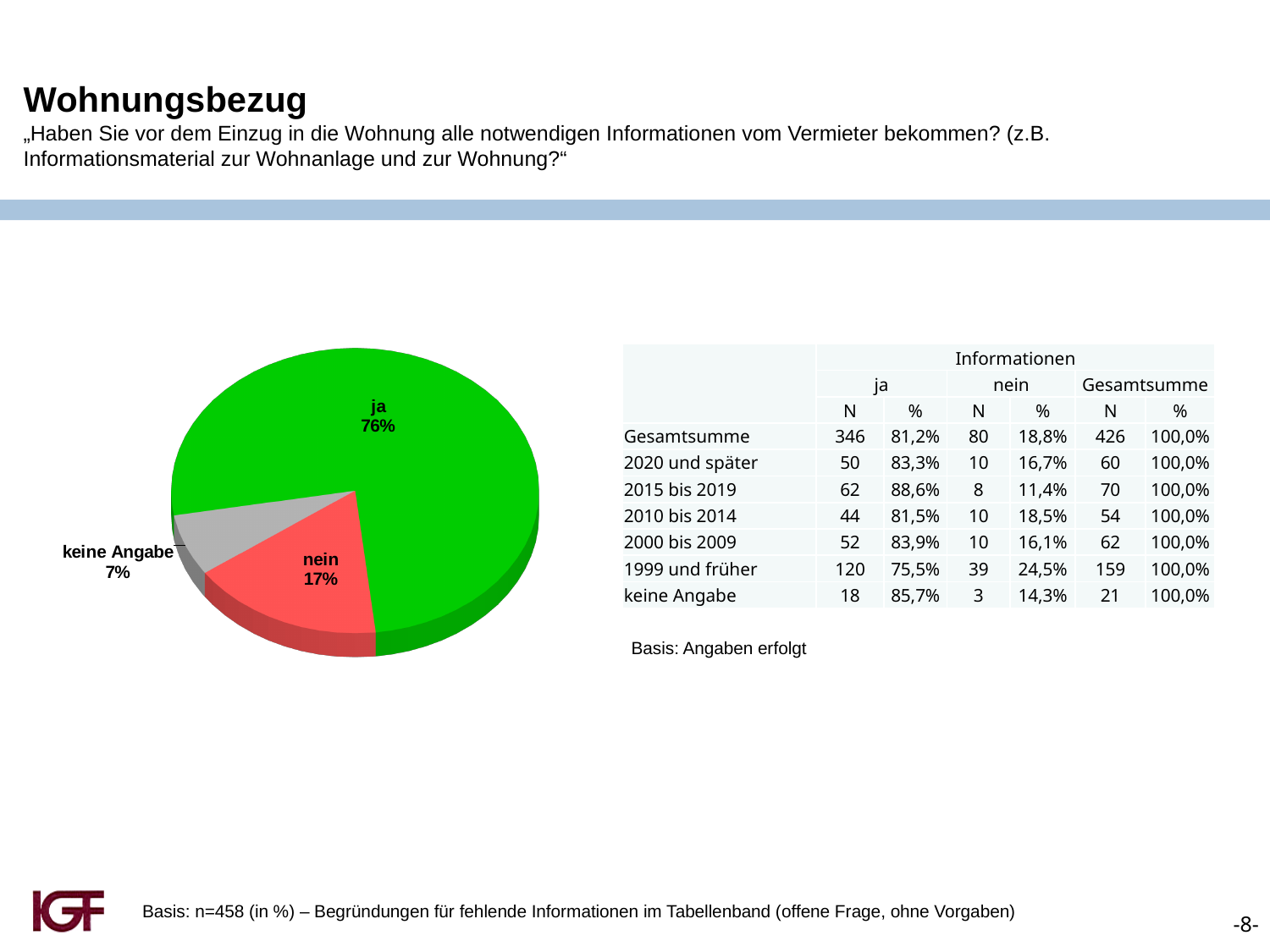
What colour is the "ja" slice of the pie chart? green What percentage of the pie chart is labelled "keine Angabe"? 7% Which slice of the pie chart is the smallest? keine Angabe What percentage of the pie chart is labelled "nein"? 17% What percentage of the pie chart is labelled "ja"? 76% Which slice of the pie chart is the largest? ja Which slice of the pie chart is larger, "nein" or "keine Angabe"? nein What colour is the "nein" slice of the pie chart? red What is the difference in percentage points between the "nein" and "keine Angabe" slices of the pie chart? 10 How many slices does the pie chart have? 3 What type of chart is shown on the slide? pie chart What is the difference in percentage points between the "ja" and "nein" slices of the pie chart? 59